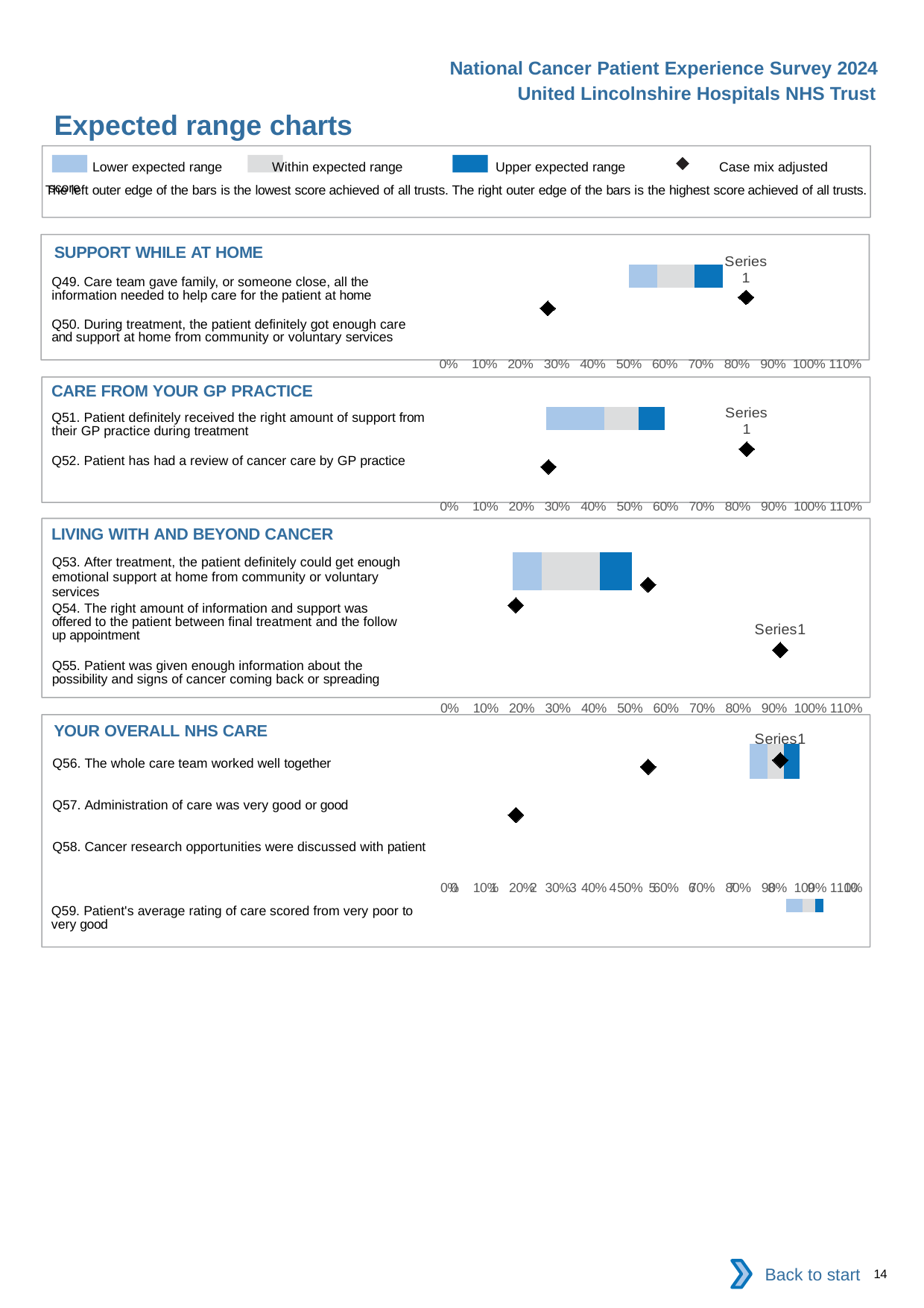
In the LIVING WITH AND BEYOND CANCER chart, is the leftmost diamond marker greater or less than 30%? less According to the legend, what does the black diamond marker represent? Case mix adjusted score According to the legend, what does the dark blue colour represent? Upper expected range How many entries does the legend at the top of the slide list? 4 In the SUPPORT WHILE AT HOME chart, is the diamond marker labelled 'Series 1' greater or less than 70%? greater In the LIVING WITH AND BEYOND CANCER chart, is the diamond marker labelled 'Series1' greater or less than 80%? greater How many question items are listed in the YOUR OVERALL NHS CARE section? 4 What is the highest percentage tick shown on the x axis of the CARE FROM YOUR GP PRACTICE chart? 110% What kind of chart is used in the SUPPORT WHILE AT HOME section? bar chart